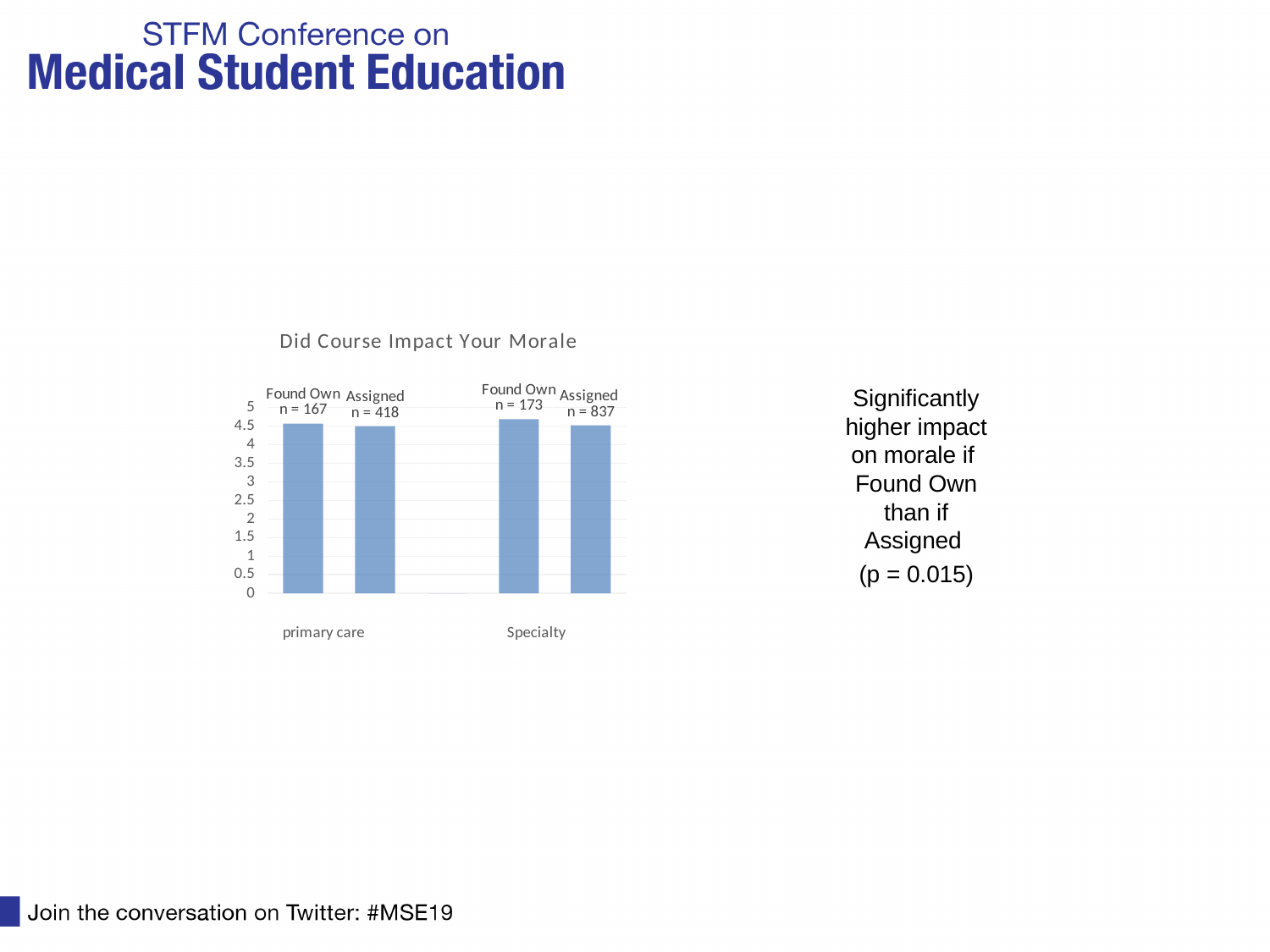
What are the two groups labelled along the x axis? primary care and Specialty In the Specialty group, which bar is taller: Found Own or Assigned? Found Own What is the sample size (n) for the Found Own bar in the primary care group? n = 167 What kind of chart is shown on the slide? bar chart What is the title of the chart? Did Course Impact Your Morale What is the sample size (n) for the Assigned bar in the primary care group? n = 418 Which bar is the highest in the chart? Found Own (Specialty) What is the sample size (n) for the Found Own bar in the Specialty group? n = 173 What is the sample size (n) for the Assigned bar in the Specialty group? n = 837 How many bars are plotted in the chart? 4 Is the value for Assigned in the primary care group greater or less than 4? greater Is the value for Found Own in the Specialty group greater or less than 4.5? greater